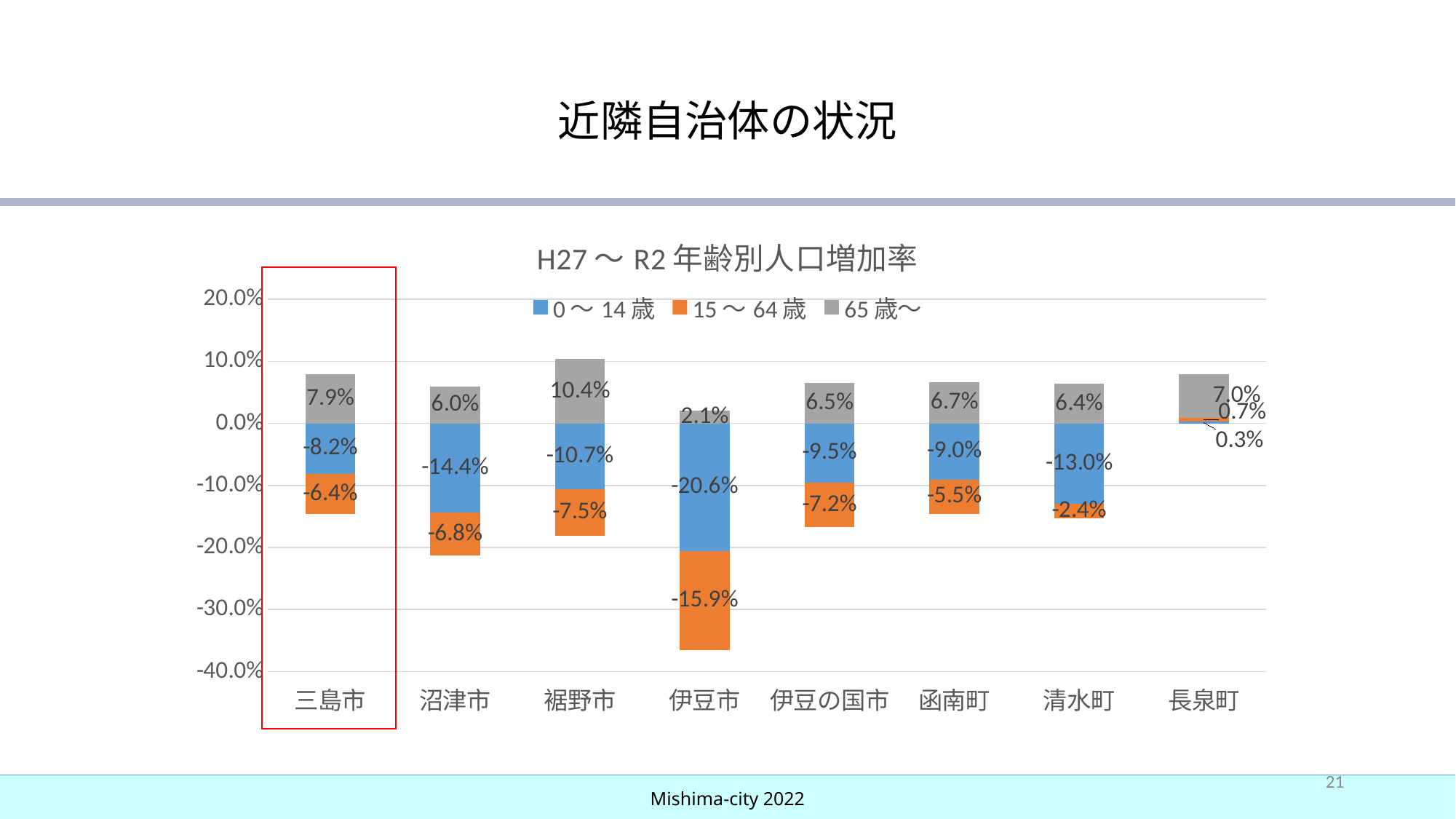
How many series does the chart legend list? 3 What kind of chart is shown on the slide? Stacked bar chart What is the 15～64歳 value for 清水町? -2.4% Which municipality has the highest 65歳～ value? 裾野市 What is the 0～14歳 value for 伊豆市? -20.6% What is the 65歳～ value for 三島市? 7.9% Which municipality has the lowest 65歳～ value? 伊豆市 How many municipalities are shown on the x axis of the chart? 8 Which is larger, the 15～64歳 value for 裾野市 or for 伊豆の国市? 伊豆の国市 What is the title of the chart? H27～R2 年齢別人口増加率 What is the difference between the 0～14歳 values for 三島市 and 沼津市? 6.2 percentage points Which municipality has the lowest 0～14歳 value? 伊豆市